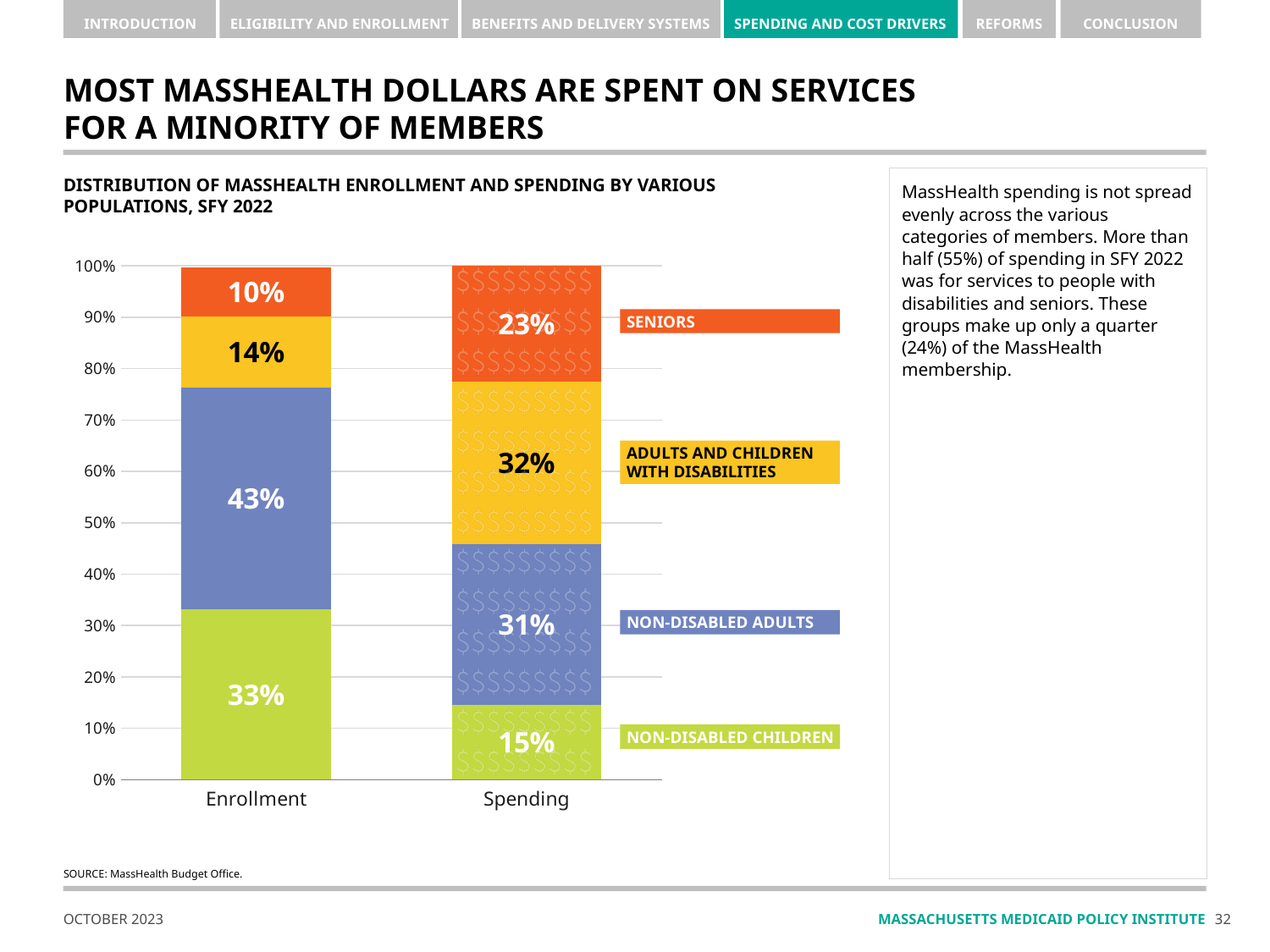
How many bars are shown in the chart? 2 What kind of chart is shown on the slide? Stacked bar chart What is the difference between the spending share and the enrollment share for adults and children with disabilities? 18 percentage points What share of spending goes to adults and children with disabilities? 32% Which population group has the largest share of enrollment? Non-disabled adults Which is larger: the enrollment share of non-disabled children or their spending share? Enrollment share How many population groups does the legend list? 4 What share of MassHealth spending goes to seniors? 23% What is the combined spending share for seniors and adults and children with disabilities? 55% What share of MassHealth enrollment is made up of seniors? 10% Which population group has the smallest share of spending? Non-disabled children What share of enrollment is non-disabled children? 33%